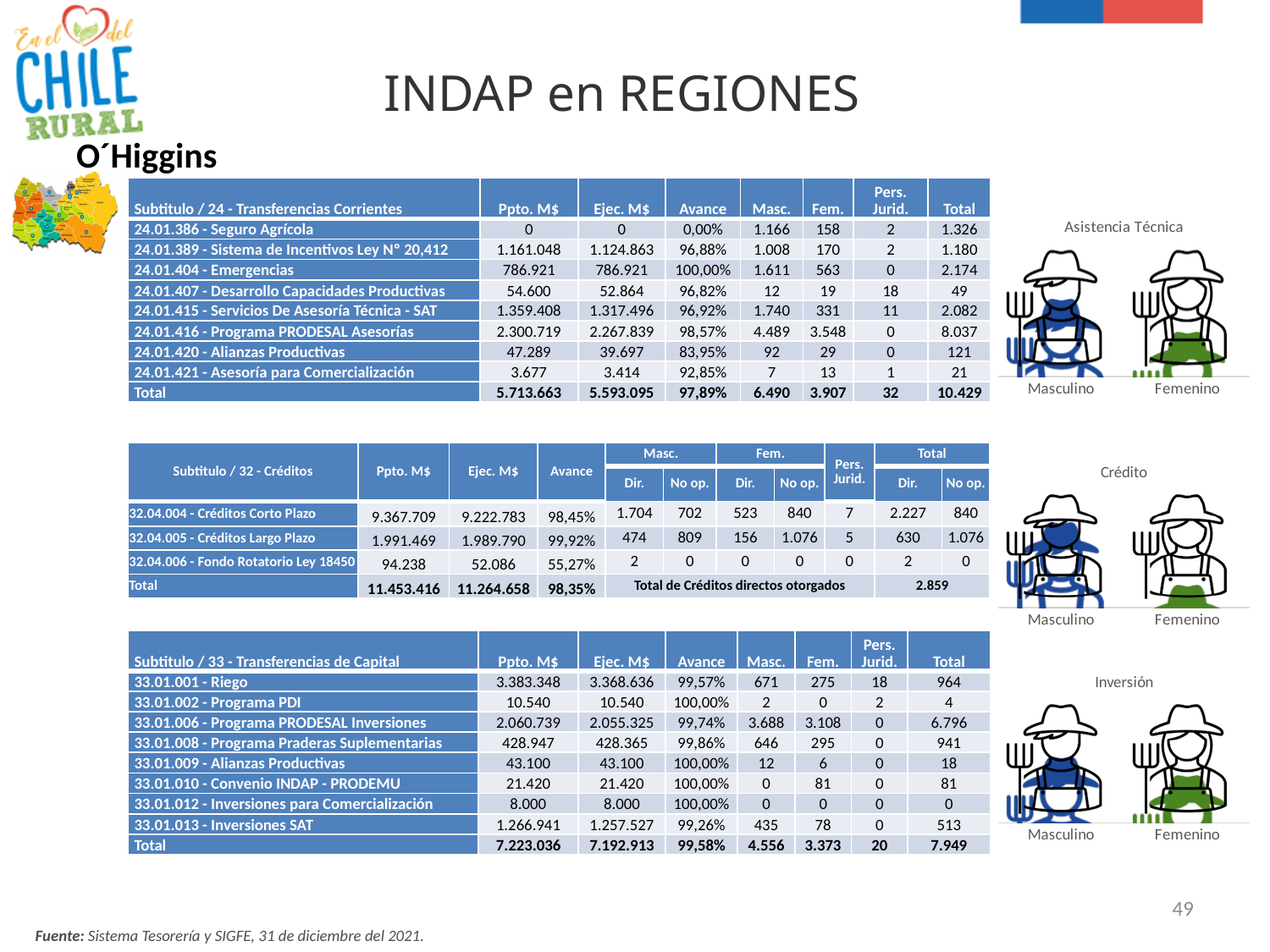
What are the titles of the three pictograph charts on the slide? Asistencia Técnica, Crédito, Inversión How many categories does the "Asistencia Técnica" chart show? 2 In the "Asistencia Técnica" chart, which category has the larger filled share, Masculino or Femenino? Masculino In the "Inversión" chart, which category has the larger filled share, Masculino or Femenino? Masculino In the "Crédito" chart, which category has the larger filled share, Masculino or Femenino? Masculino In the "Inversión" chart, what colour is the Femenino figure filled with? green What kind of chart is the "Asistencia Técnica" figure on the right of the slide? pictograph (filled icon chart) In the "Crédito" chart, which category has the smaller filled share? Femenino How many pictograph charts are shown on the right side of the slide? 3